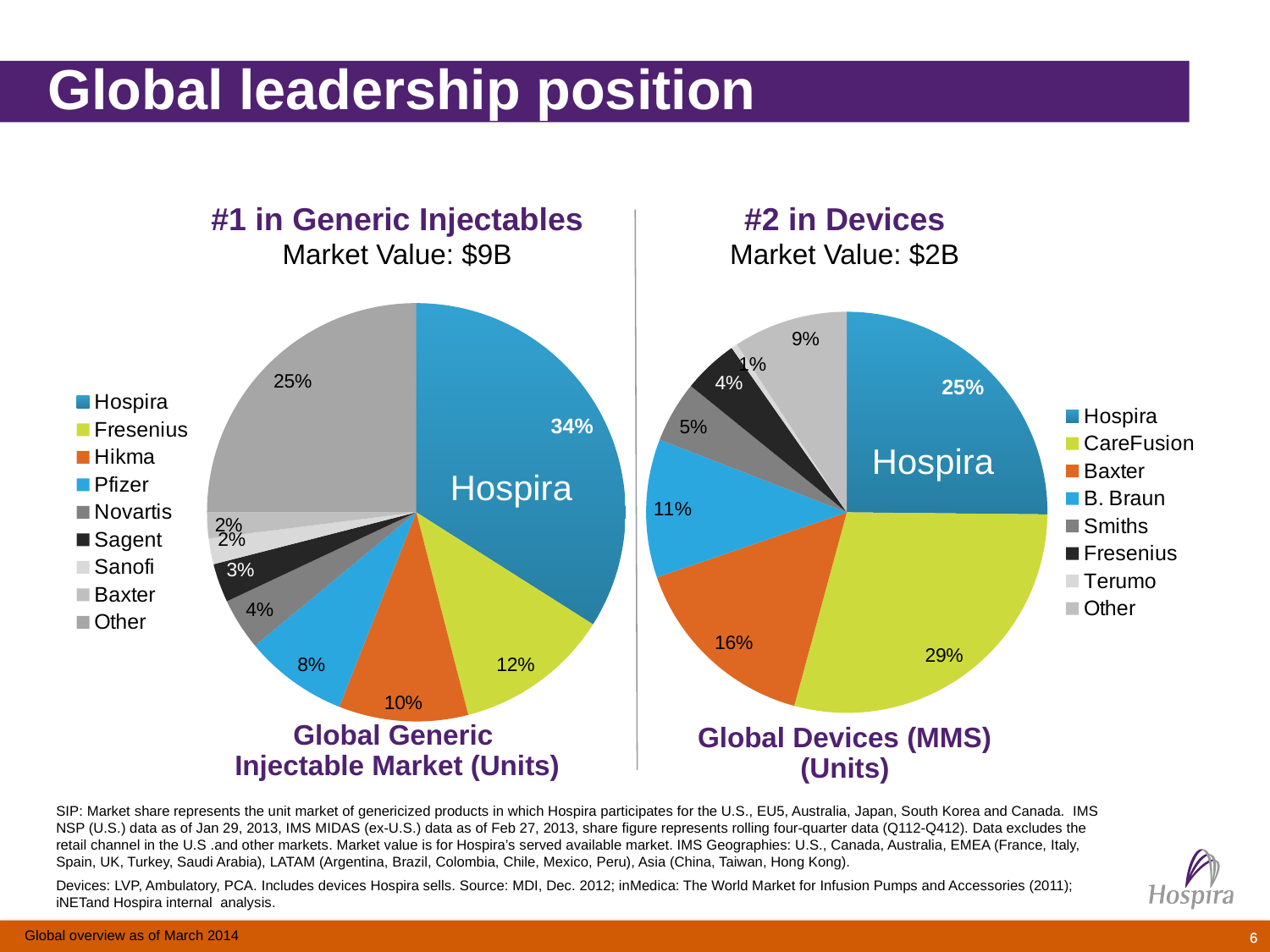
In the Global Devices (MMS) (Units) chart, which company has the smallest share? Terumo How many entries does the legend of the Global Devices (MMS) (Units) chart list? 8 How many entries does the legend of the Global Generic Injectable Market (Units) chart list? 9 In the Global Generic Injectable Market (Units) chart, what share does Hospira hold? 34% In the Global Generic Injectable Market (Units) chart, which is larger, Pfizer's share or Hikma's share? Hikma In the Global Generic Injectable Market (Units) chart, what share does Hikma hold? 10% In the Global Generic Injectable Market (Units) chart, what is the difference between Hospira's share and Fresenius's share? 22% What type of chart is used for the Global Devices (MMS) (Units) data? Pie chart In the Global Devices (MMS) (Units) chart, which company has the largest share? CareFusion In the Global Devices (MMS) (Units) chart, what share does CareFusion hold? 29% In the Global Devices (MMS) (Units) chart, what is the difference between CareFusion's share and Hospira's share? 4% In the Global Devices (MMS) (Units) chart, what share does B. Braun hold? 11%